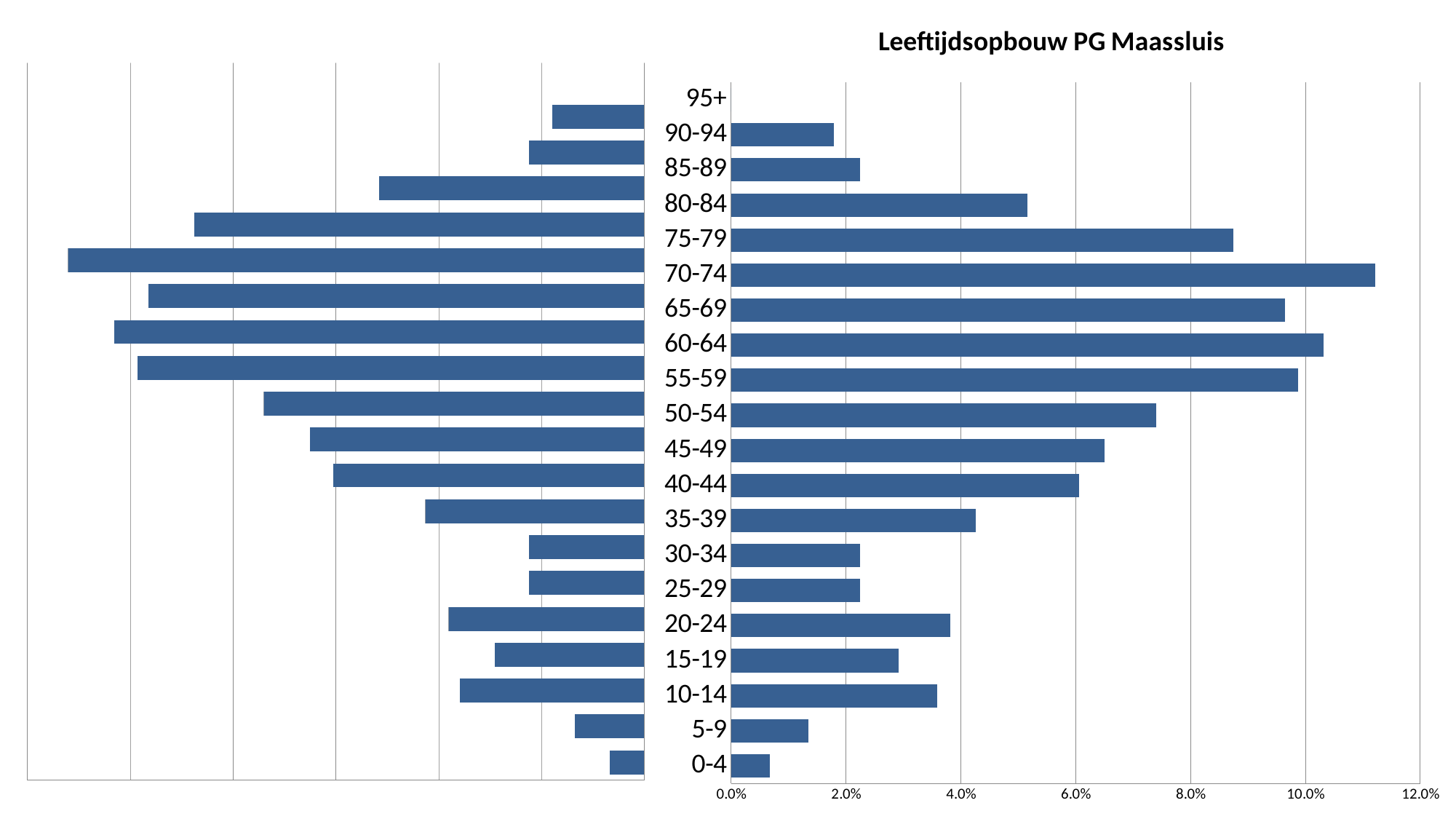
In the right-hand chart, is the value for 55-59 greater or less than 8.0%? greater What is the highest value shown on the horizontal axis of the right-hand chart? 12.0% How many age categories are listed on the chart? 20 What kind of chart is shown on the slide? bar chart In the right-hand chart, is the value for 0-4 greater or less than 2.0%? less In the right-hand chart, which is larger, the value for 60-64 or the value for 65-69? 60-64 In the right-hand chart, is the value for 80-84 greater or less than 4.0%? greater What is the title of the chart on the slide? Leeftijdsopbouw PG Maassluis In the right-hand chart, which age category has the highest value? 70-74 In the right-hand chart, which is larger, the value for 75-79 or the value for 80-84? 75-79